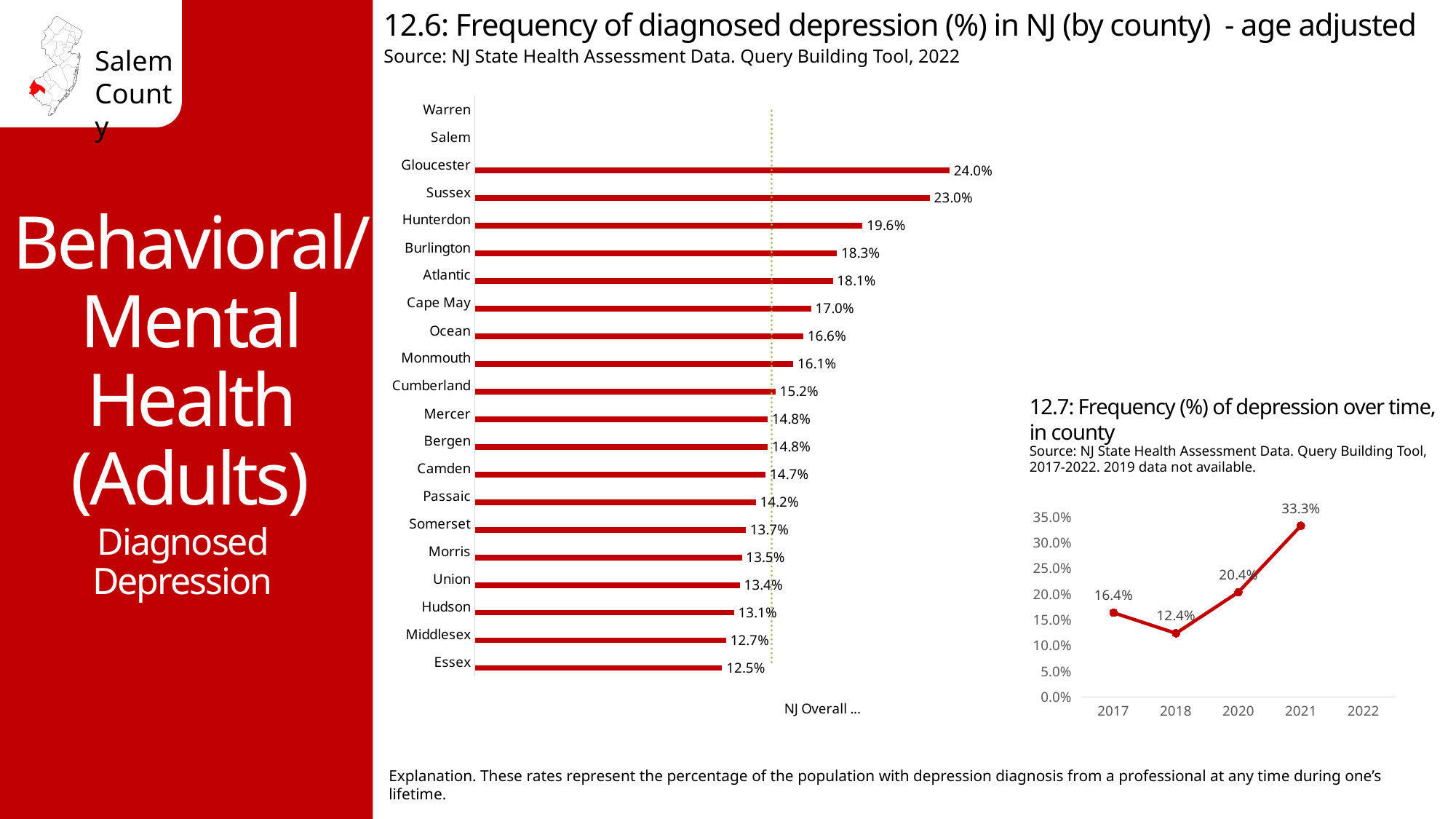
In chart 12.6, what is the value shown for Cumberland? 15.2% In chart 12.7, what is the frequency of depression in 2018? 12.4% In chart 12.6, which county has a higher value, Hunterdon or Burlington? Hunterdon In chart 12.6, which county has the lowest frequency of diagnosed depression among those with a bar? Essex In chart 12.6, what is the frequency of diagnosed depression for Gloucester? 24.0% In chart 12.7, what is the difference between the 2021 and 2020 values? 12.9% What kind of chart is chart 12.6? Bar chart In chart 12.6, which county has the highest frequency of diagnosed depression among those with a bar? Gloucester In chart 12.6, which two counties have no bar plotted? Warren and Salem In chart 12.6, what is the difference between the values for Gloucester and Sussex? 1.0% In chart 12.7, what is the frequency of depression in 2021? 33.3% In chart 12.7, which year has the lowest plotted value? 2018